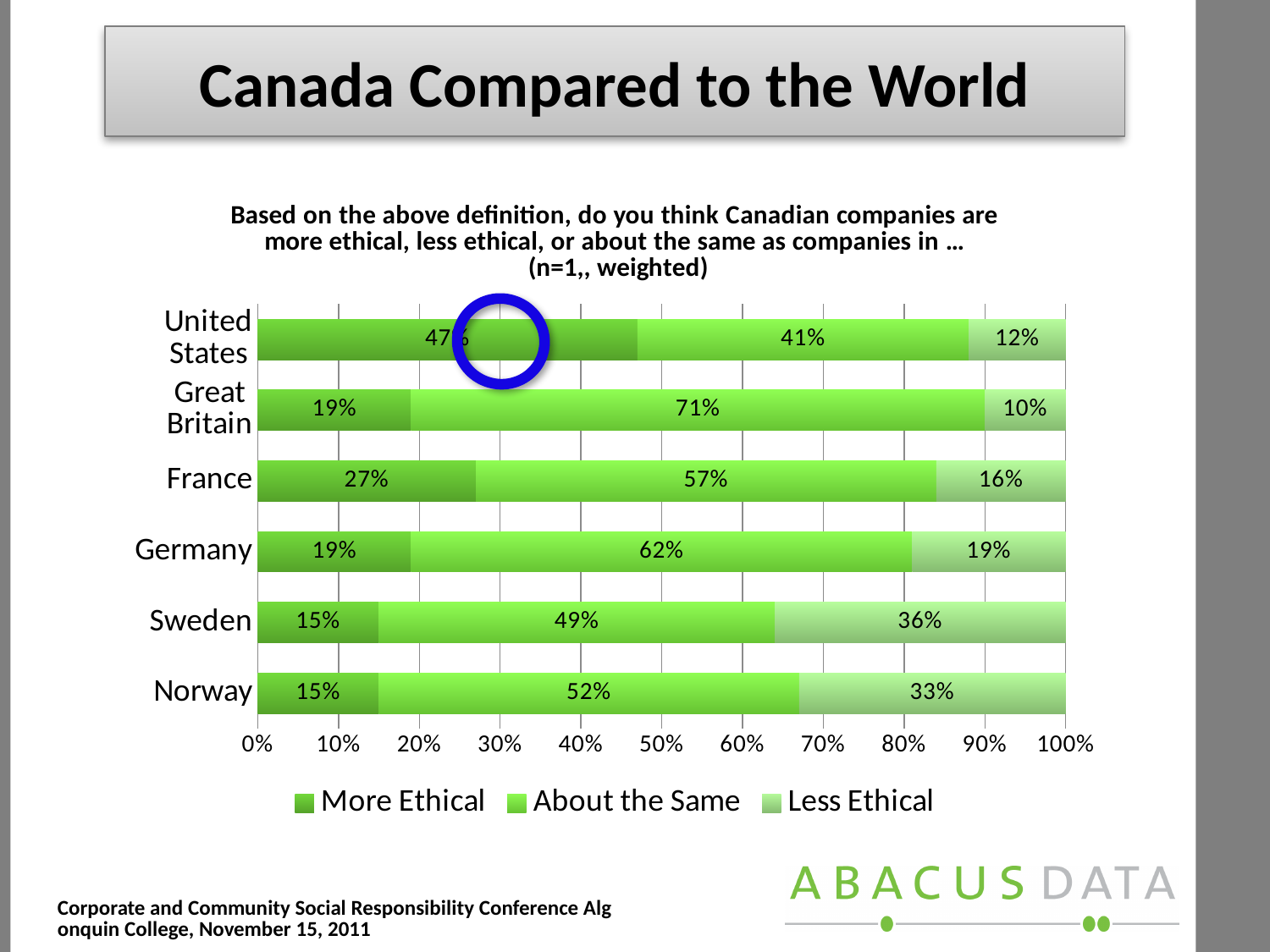
What percentage of respondents said Canadian companies are 'About the Same' as companies in Great Britain? 71% What kind of chart is shown on the slide? Stacked bar chart Is the 'More Ethical' value for the United States greater or less than 40%? greater How many series does the legend list? 3 What is the difference between the 'Less Ethical' values for Sweden and Norway? 3% What is the total of the stacked bar for Germany? 100% How many countries are shown on the chart? 6 What is the 'Less Ethical' value for Sweden? 36% Which is larger, the 'About the Same' value for Germany or for France? Germany What is the 'More Ethical' value for France? 27% Which country has the lowest 'Less Ethical' value? Great Britain Which country has the highest 'About the Same' value? Great Britain